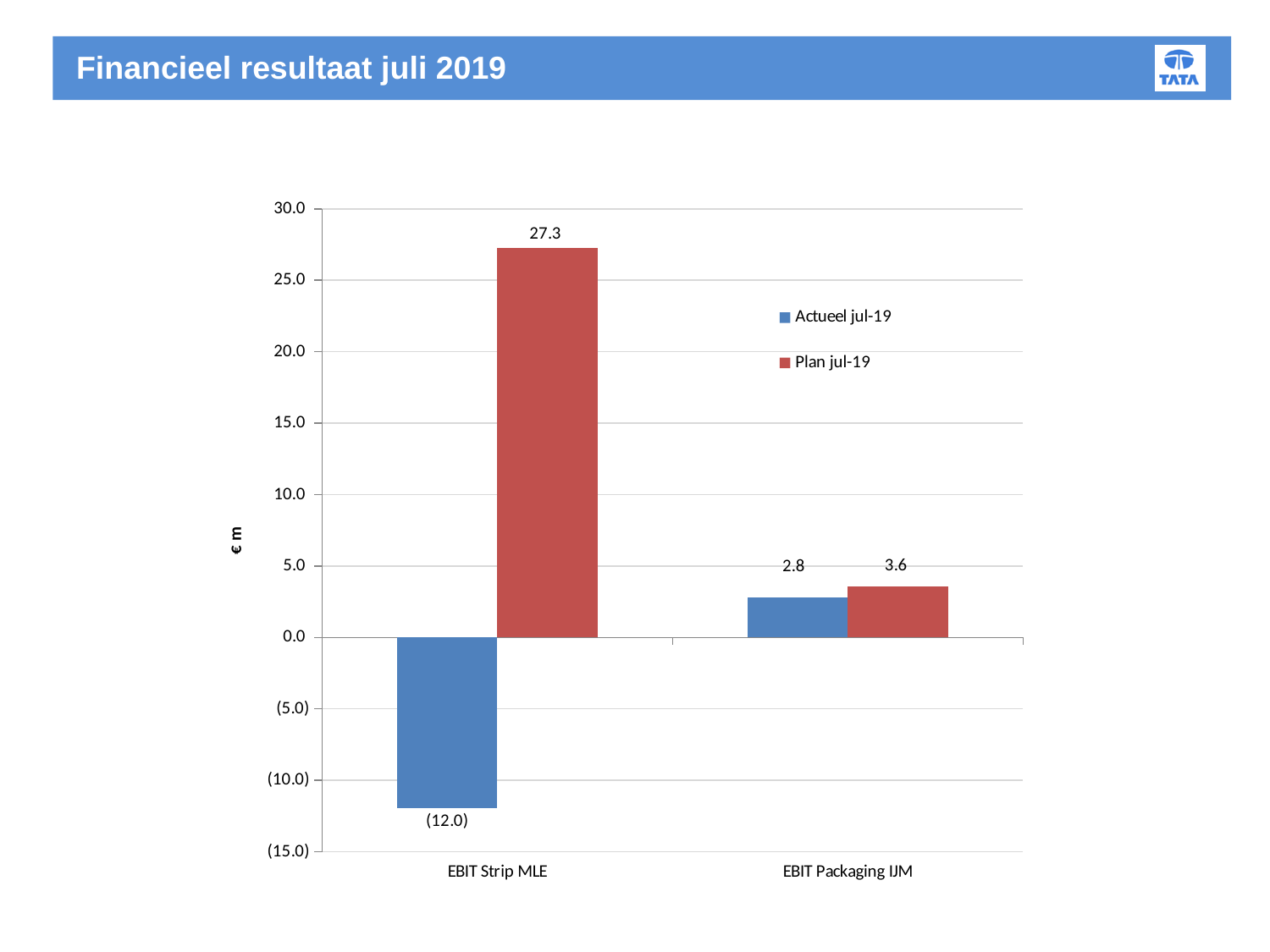
Which bar has the highest value on the chart? Plan jul-19 for EBIT Strip MLE What kind of chart is shown on the slide? Bar chart For EBIT Packaging IJM, which is larger: Actueel jul-19 or Plan jul-19? Plan jul-19 Is the Plan jul-19 value for EBIT Strip MLE greater or less than 25.0? greater What is the Actueel jul-19 value for EBIT Packaging IJM? 2.8 What is the Actueel jul-19 value for EBIT Strip MLE? (12.0) What is the Plan jul-19 value for EBIT Strip MLE? 27.3 Which bar has the lowest value on the chart? Actueel jul-19 for EBIT Strip MLE How many categories are shown on the x axis? 2 What is the Plan jul-19 value for EBIT Packaging IJM? 3.6 What is the difference between the Plan jul-19 and Actueel jul-19 values for EBIT Packaging IJM? 0.8 How many series does the legend list? 2